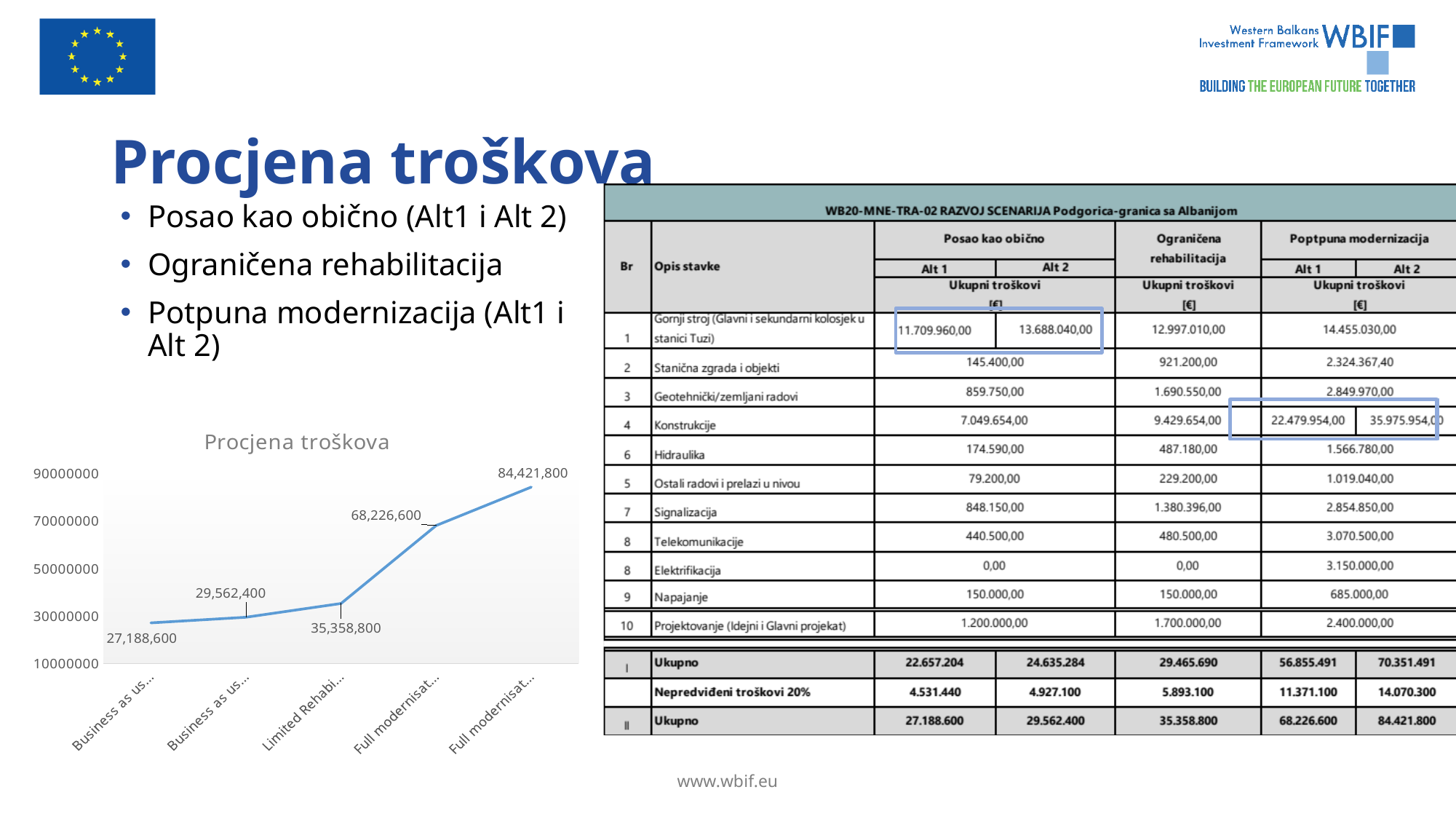
Which point on the line chart has the highest value? the last (rightmost) point, 84,421,800 Is the value of the fourth point on the line chart greater or less than 50000000? greater How many data points are plotted on the line chart? 5 What is the value of the third point on the line chart, labelled 'Limited Rehabi...'? 35,358,800 What is the value of the first (leftmost) point on the line chart? 27,188,600 What kind of chart is shown on the slide? line chart What is the difference between the last point (84,421,800) and the fourth point (68,226,600) on the line chart? 16,195,200 What is the value of the last (rightmost) point on the line chart? 84,421,800 Which point on the line chart has the lowest value? the first (leftmost) point, 27,188,600 What is the value of the second point on the line chart? 29,562,400 Do the values on the line chart rise or fall from left to right? rise What is the title of the chart on the slide? Procjena troškova